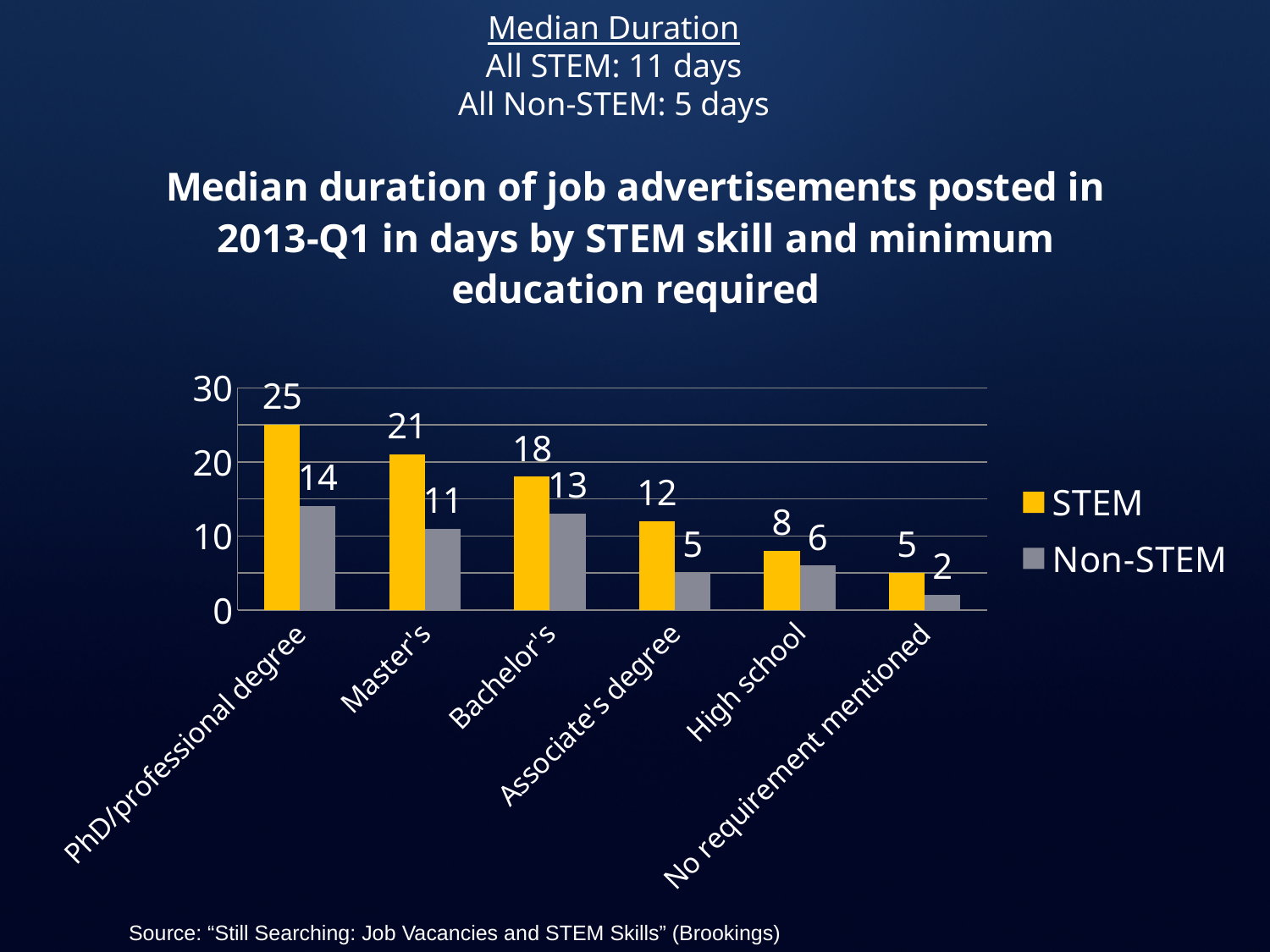
What is the Non-STEM value for Bachelor's? 13 Which is larger for Associate's degree, the STEM value or the Non-STEM value? STEM Which education category has the lowest Non-STEM value? No requirement mentioned Which colour represents the Non-STEM series in the legend? Grey What is the STEM value for Master's? 21 How many education categories are shown on the x axis? 6 What is the STEM value for High school? 8 What kind of chart is shown on the slide? Bar chart How many series does the legend list? 2 Which education category has the highest STEM value? PhD/professional degree Do the STEM values rise or fall moving from PhD/professional degree to No requirement mentioned? Fall What is the difference between the STEM and Non-STEM values for PhD/professional degree? 11